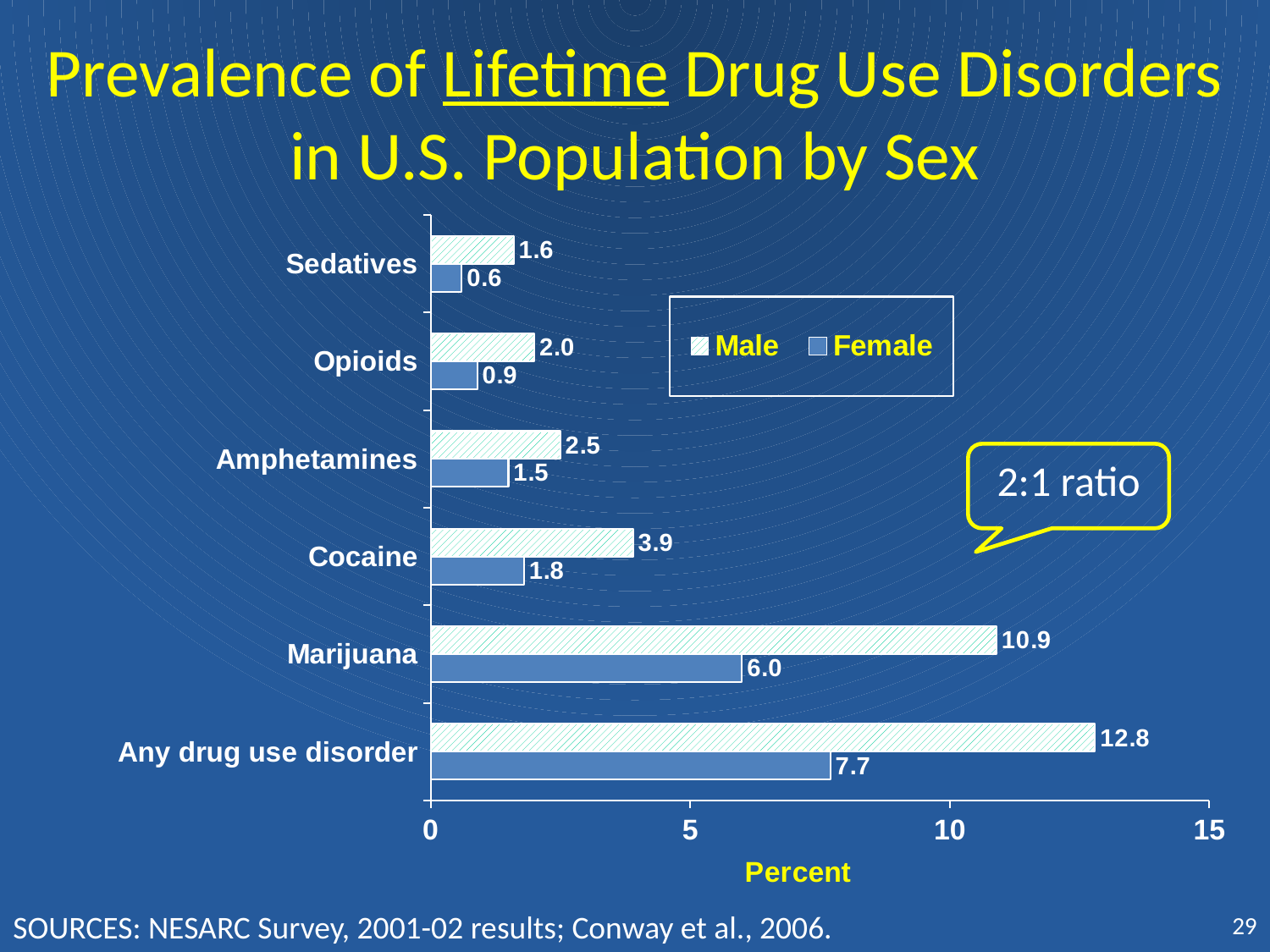
How many series does the legend list? 2 What is the Male value for Marijuana? 10.9 What kind of chart is shown on the slide? Bar chart Is the Male value for Any drug use disorder greater or less than 10? greater What is the difference between the Male and Female values for Marijuana? 4.9 What is the Female value for Cocaine? 1.8 What is the Female value for Any drug use disorder? 7.7 Which is larger, the Male value for Opioids or the Male value for Amphetamines? Male value for Amphetamines What is the label of the x axis? Percent Which category has the highest Male value? Any drug use disorder Which category has the lowest Female value? Sedatives How many categories are shown on the chart? 6